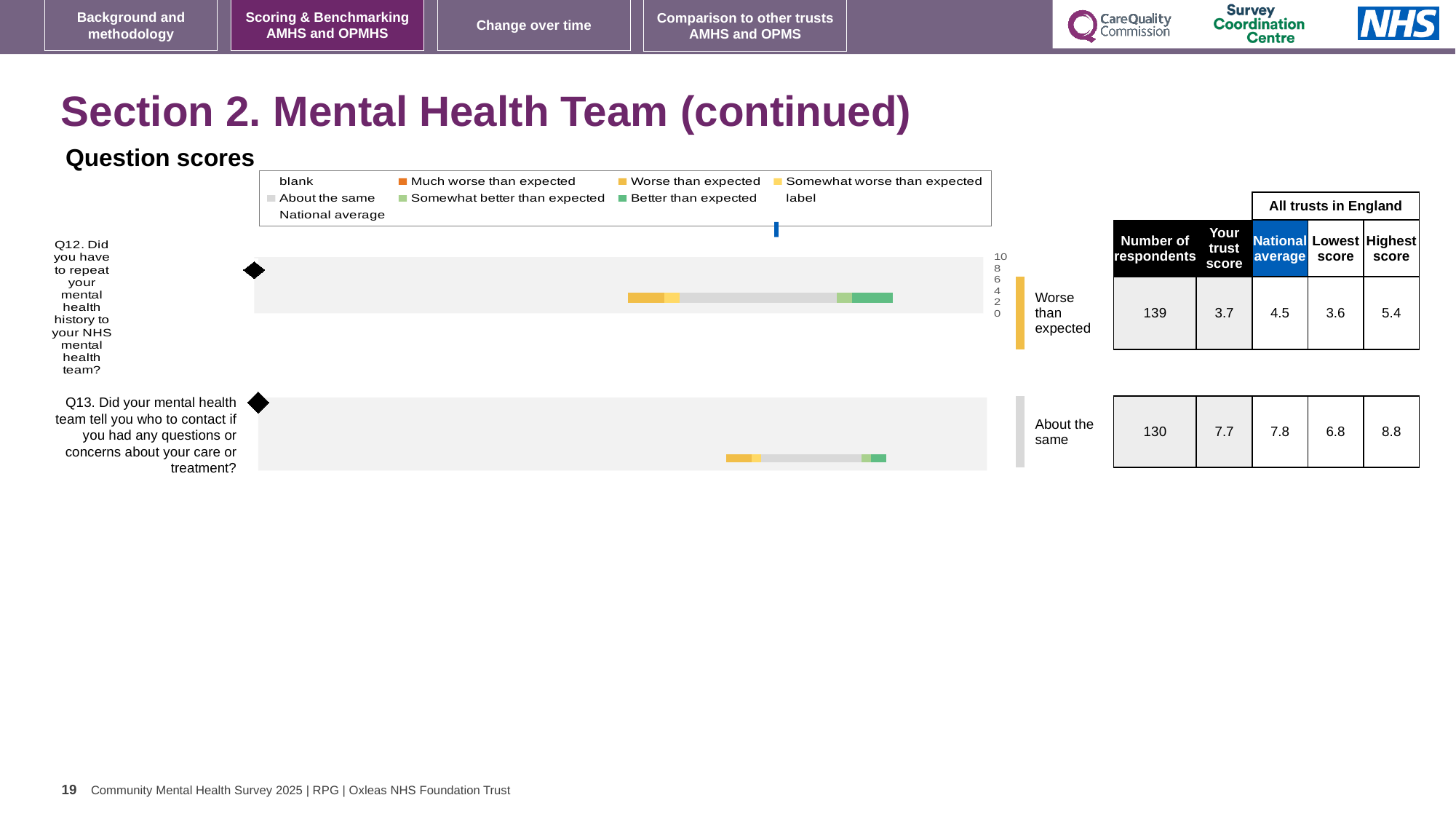
What is the difference between the highest score and the lowest score for Q12? 1.8 Which question has more respondents, Q12 or Q13? Q12 Which benchmark category is shown next to the bar for Q13 in the question scores chart? About the same How many respondents are listed for Q12 (repeating mental health history)? 139 What kind of chart is used to show the question scores on this slide? bar chart What is the national average for Q13 (who to contact with questions or concerns)? 7.8 For Q13, which is larger: the trust score or the national average? national average How many questions are plotted in the question scores chart? 2 What is the highest score across all trusts in England for Q12? 5.4 What is the trust score for Q12 (repeating mental health history)? 3.7 Which benchmark category is shown next to the bar for Q12 in the question scores chart? Worse than expected What is the lowest score across all trusts in England for Q13? 6.8